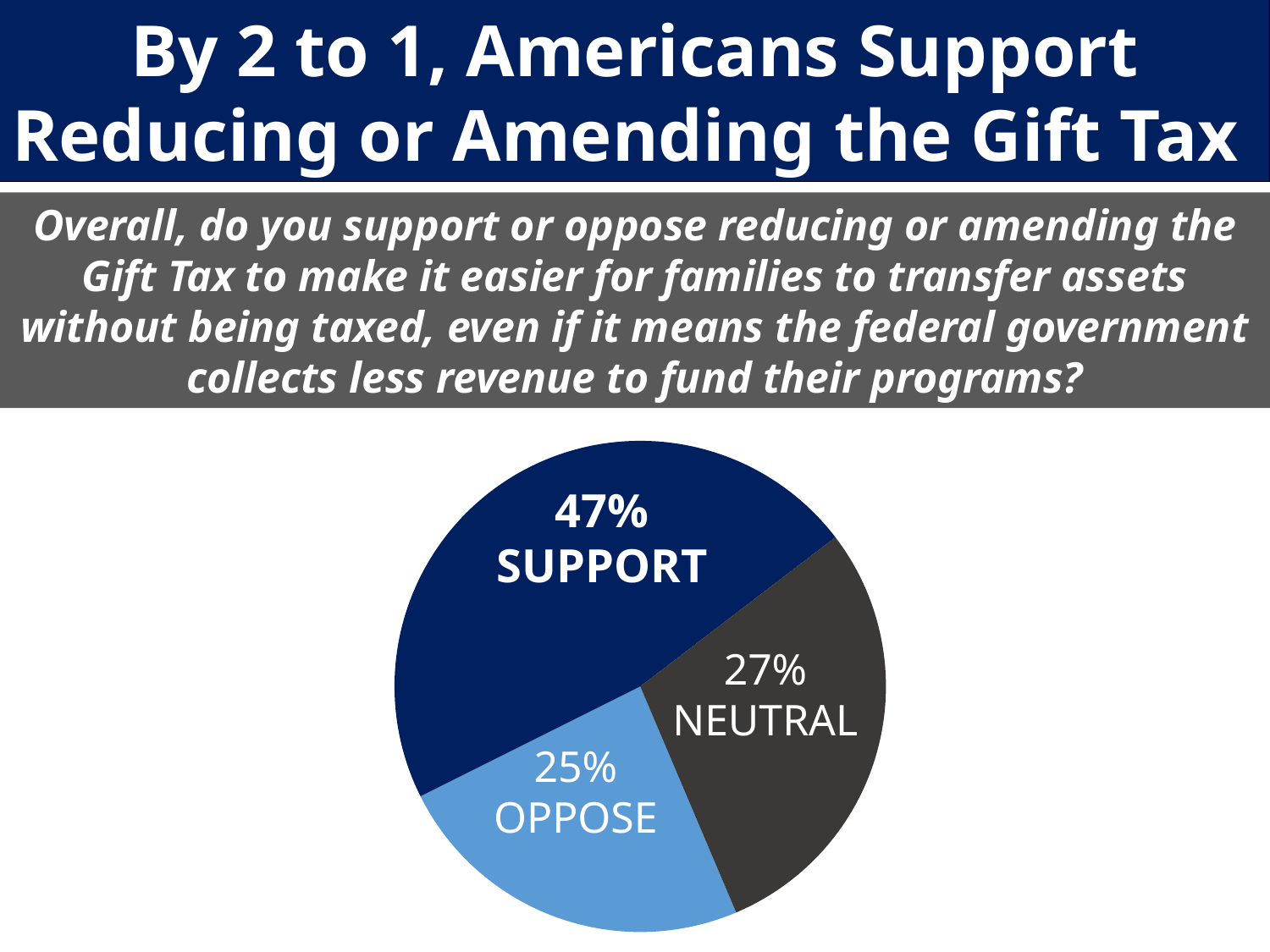
What percentage of respondents are neutral? 27% Which response has the largest share of the pie? Support What is the difference in percentage points between Neutral and Oppose? 2 Which response has the smallest share of the pie? Oppose What percentage of respondents support reducing or amending the Gift Tax? 47% What colour is the Support slice? Dark navy blue What percentage of respondents oppose reducing or amending the Gift Tax? 25% What is the difference in percentage points between Support and Oppose? 22 What kind of chart is shown on the slide? Pie chart What colour is the Oppose slice? Light blue Which is larger, the Support share or the Neutral share? Support How many slices does the pie chart have? 3